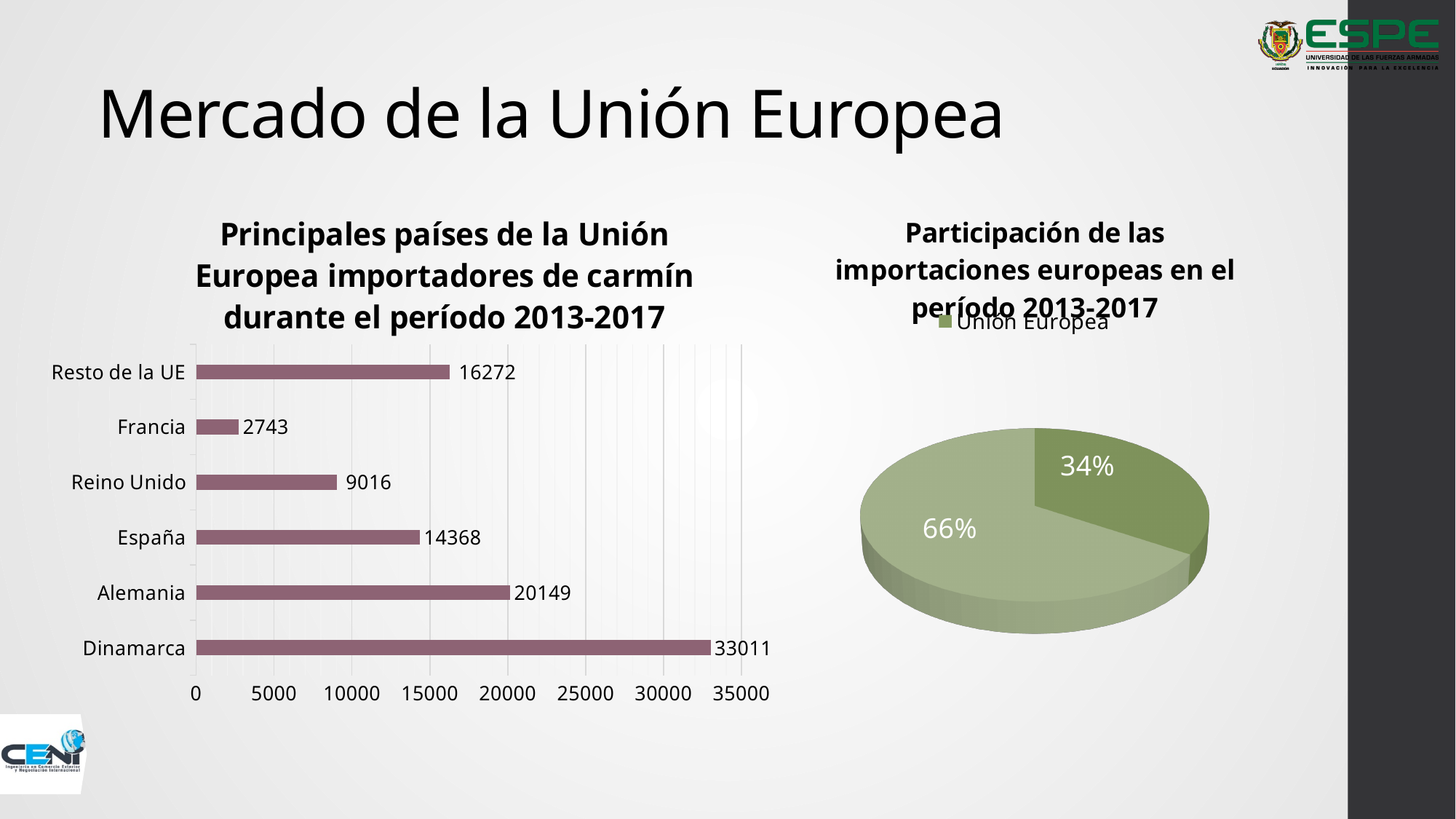
How many categories are shown in the bar chart on the left? 6 What is the legend entry shown for the pie chart on the right? Unión Europea In the bar chart on the left, what is the difference between the values for Dinamarca and Alemania? 12862 In the bar chart on the left, what is the value for Resto de la UE? 16272 In the bar chart on the left, which country has the highest value? Dinamarca What kind of chart is the chart on the left of the slide? bar chart In the bar chart on the left, is the value for Reino Unido greater or less than 10000? less In the bar chart on the left, which is larger, the value for España or the value for Reino Unido? España In the bar chart 'Principales países de la Unión Europea importadores de carmín durante el período 2013-2017', what is the value for Alemania? 20149 In the bar chart on the left, what is the value for Francia? 2743 In the bar chart on the left, which category has the lowest value? Francia In the pie chart 'Participación de las importaciones europeas en el período 2013-2017', what share does the larger slice have? 66%